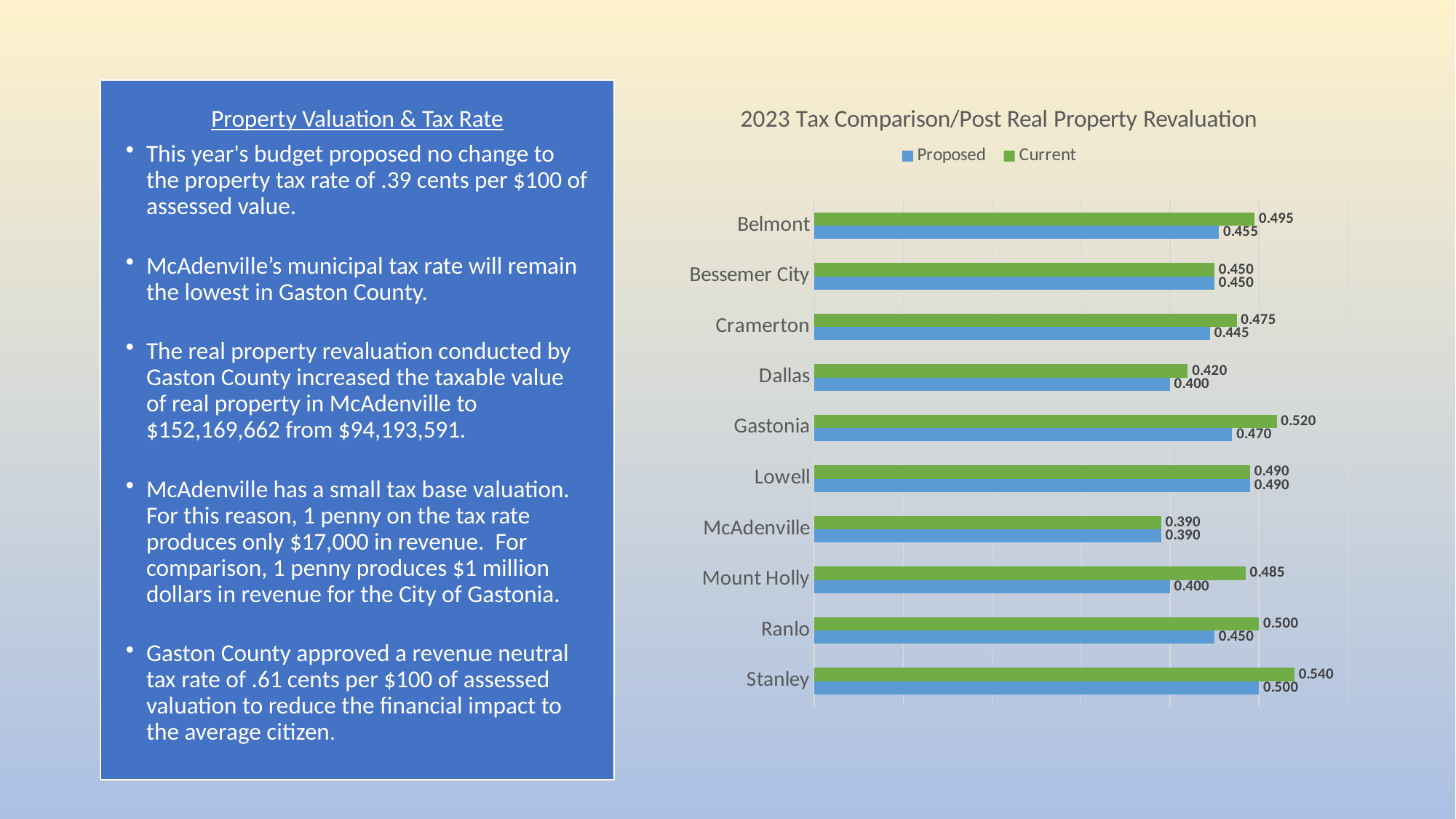
What is the Proposed tax rate for Mount Holly? 0.400 What kind of chart is shown on the slide? Bar chart What is the title of the chart? 2023 Tax Comparison/Post Real Property Revaluation Which is larger, the Proposed rate for Belmont or the Proposed rate for Gastonia? Gastonia What is the difference between the Current and Proposed tax rates for Mount Holly? 0.085 What is the difference between the Current and Proposed tax rates for Stanley? 0.040 What is the Current tax rate for Gastonia? 0.520 Which municipality has the highest Current tax rate? Stanley Which colour represents the Current series in the chart? Green Which municipality has the lowest Proposed tax rate? McAdenville How many series does the legend list? 2 How many municipalities are shown in the chart? 10